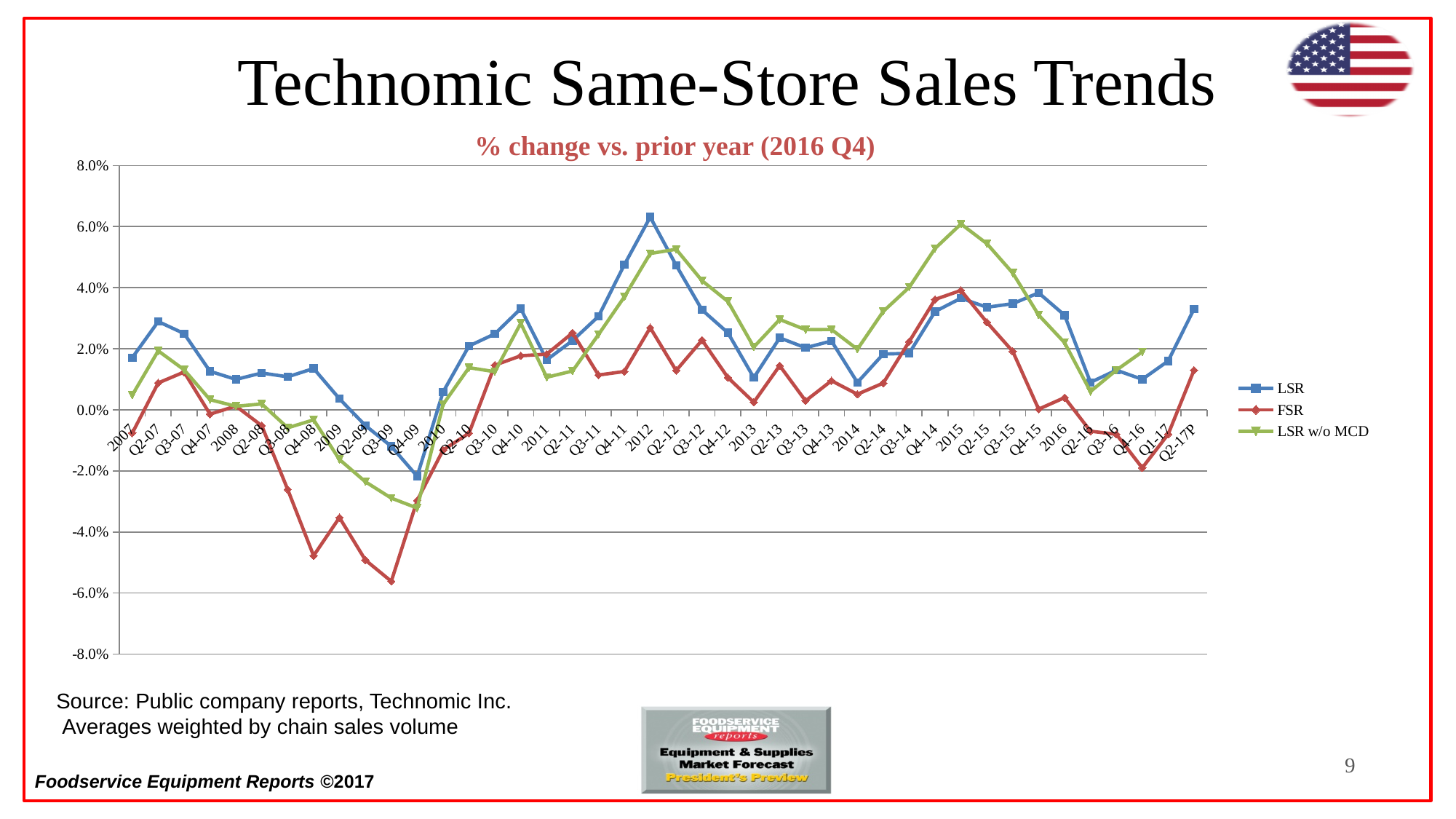
At 2012, which series has the larger value, LSR or FSR? LSR At which period does the FSR series reach its lowest value? Q3-09 What kind of chart is shown on the slide? line chart At which period does the LSR series reach its highest value? 2012 What are the three series named in the legend? LSR, FSR, LSR w/o MCD Is the FSR value for Q3-09 greater or less than -4.0%? less How many series does the legend list? 3 Is the FSR value for Q4-16 greater or less than 0.0%? less At which period does the LSR w/o MCD series reach its highest value? 2015 Does the FSR series rise or fall from Q4-07 to Q4-08? fall What is the subtitle printed above the chart? % change vs. prior year (2016 Q4) Is the LSR value for 2012 greater or less than 4.0%? greater